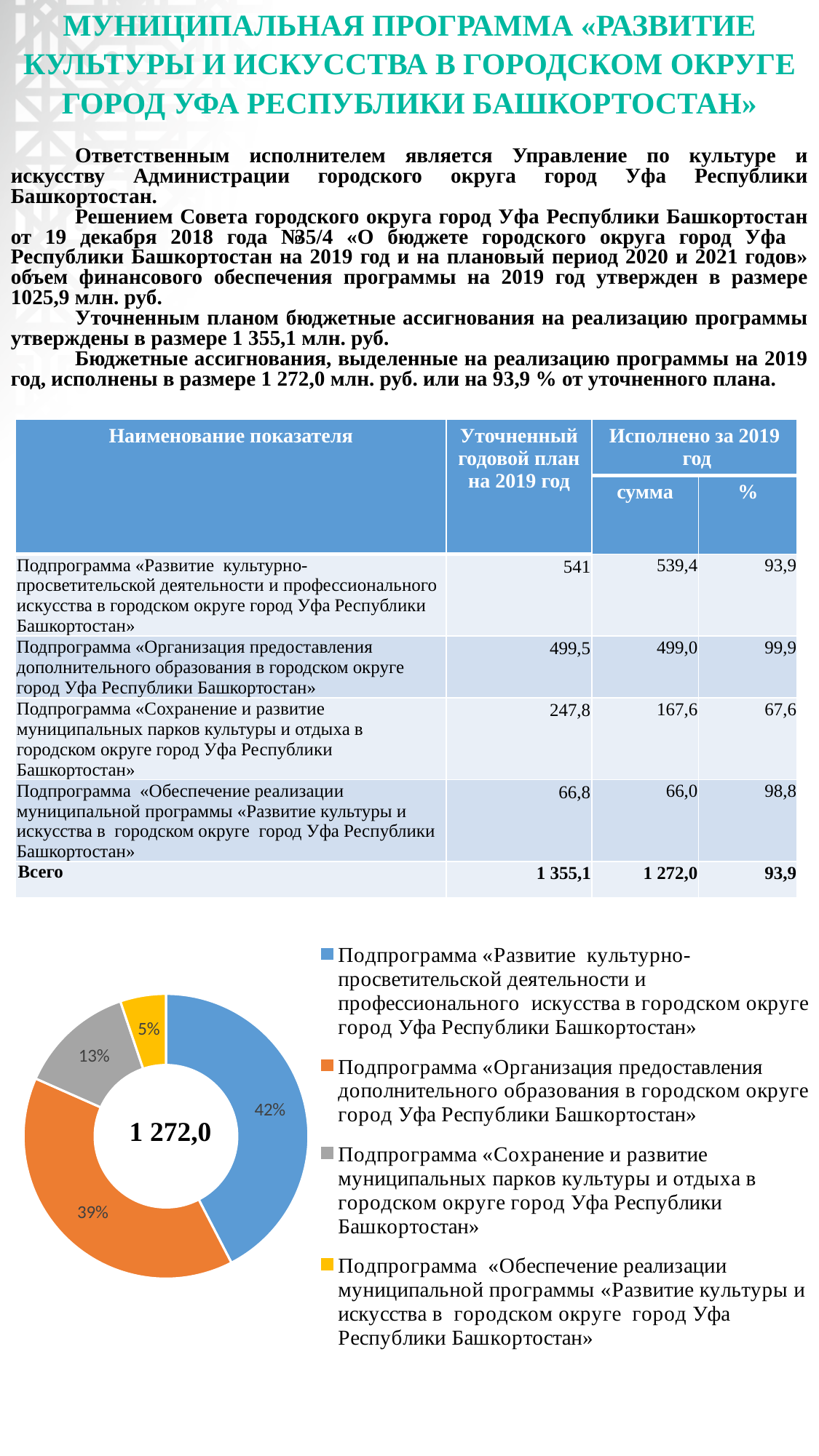
Which slice of the doughnut chart is the largest? Подпрограмма «Развитие культурно-просветительской деятельности и профессионального искусства в городском округе город Уфа Республики Башкортостан» (42%) In the doughnut chart, what share is shown for the subprogramme «Сохранение и развитие муниципальных парков культуры и отдыха в городском округе город Уфа Республики Башкортостан»? 13% What colour is the slice representing the subprogramme «Сохранение и развитие муниципальных парков культуры и отдыха» in the doughnut chart? gray What kind of chart is shown at the bottom of the slide? doughnut (pie) chart In the doughnut chart, what share is shown for the subprogramme «Развитие культурно-просветительской деятельности и профессионального искусства в городском округе город Уфа Республики Башкортостан»? 42% What value is printed in the centre of the doughnut chart? 1 272,0 How many slices does the doughnut chart have? 4 In the doughnut chart, what share is shown for the subprogramme «Обеспечение реализации муниципальной программы «Развитие культуры и искусства в городском округе город Уфа Республики Башкортостан»? 5% How many entries does the legend of the doughnut chart list? 4 In the doughnut chart, what is the difference in percentage points between the 42% slice and the 39% slice? 3 percentage points Which slice of the doughnut chart is the smallest? Подпрограмма «Обеспечение реализации муниципальной программы «Развитие культуры и искусства в городском округе город Уфа Республики Башкортостан» (5%)